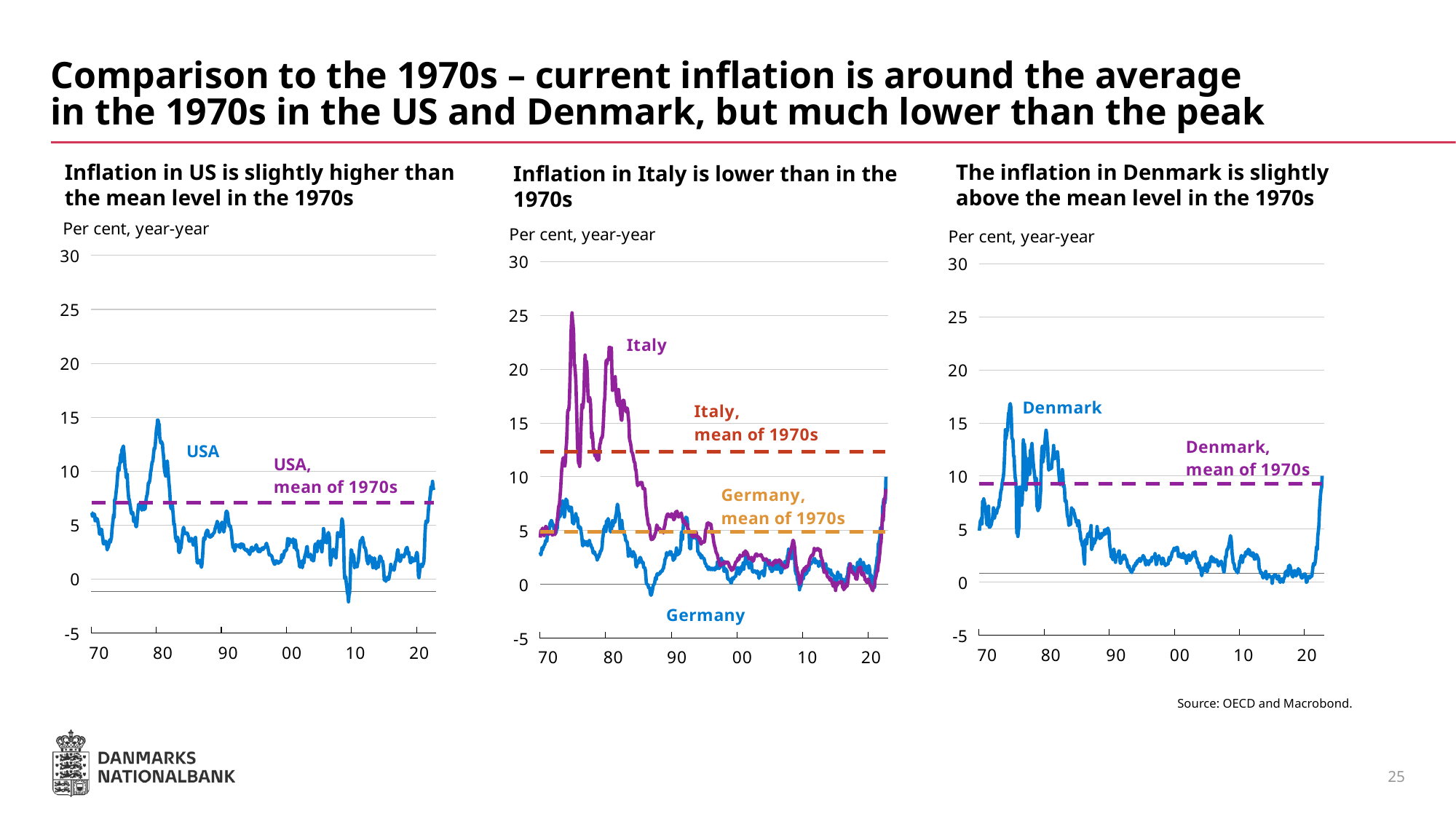
In the left chart, is the 'USA, mean of 1970s' line greater or less than 5? greater In the middle chart, is the 'Italy, mean of 1970s' line greater or less than 10? greater In the middle chart, how many countries' inflation series are plotted? 2 In the middle chart, which country reached the higher peak inflation in the 1970s, Italy or Germany? Italy In the left chart, does US inflation generally rise or fall between 1980 and 1990? fall In the middle chart, which is higher: the Italy mean of the 1970s or the Germany mean of the 1970s? Italy, mean of 1970s In the middle chart, is the peak value of Italy's inflation in the mid-1970s greater or less than 20? greater What kind of chart is the left chart titled 'Inflation in US is slightly higher than the mean level in the 1970s'? Line chart What is the title of the right chart? The inflation in Denmark is slightly above the mean level in the 1970s